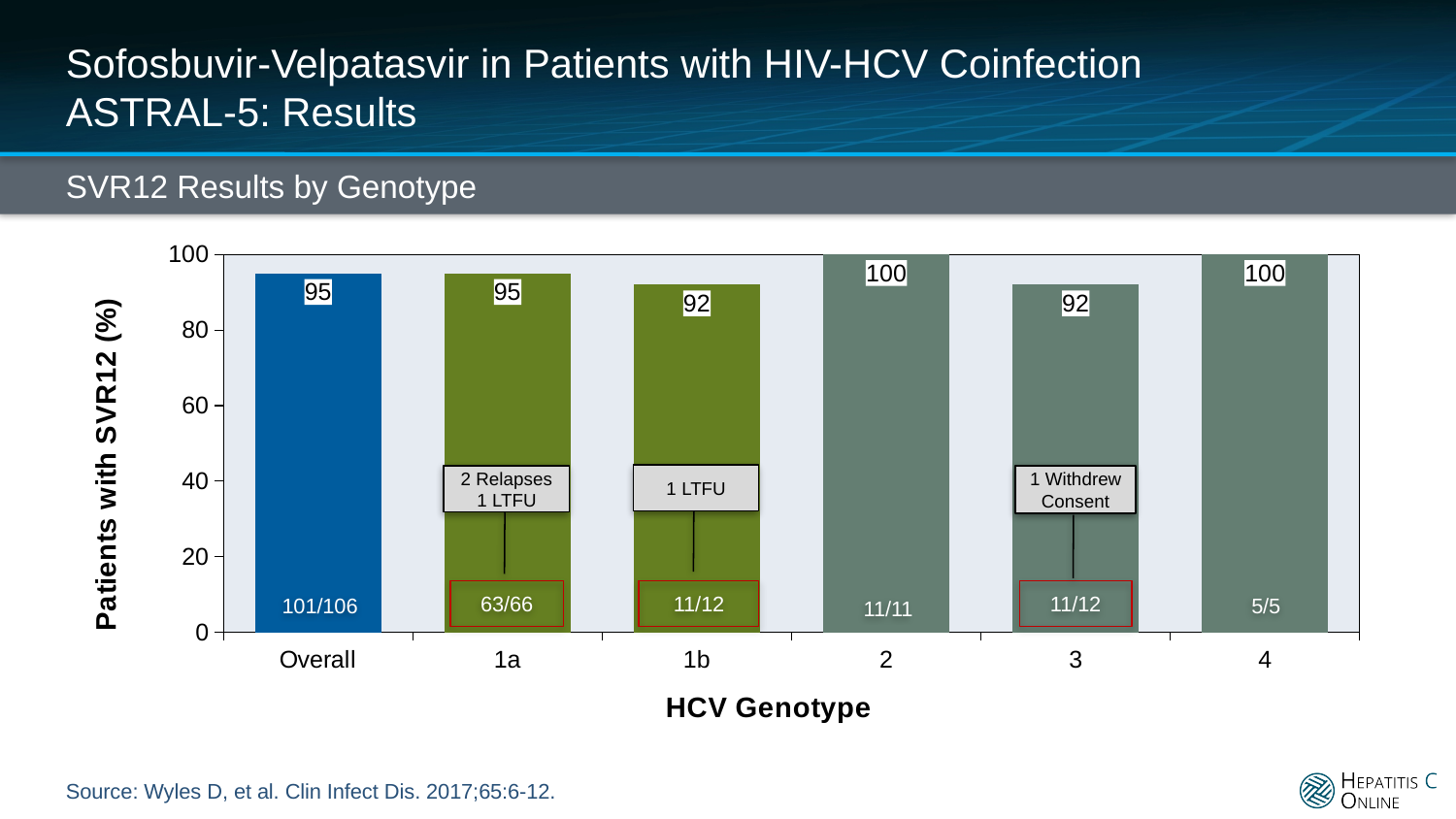
What is the SVR12 rate (%) for HCV genotype 3? 92 What is the difference in SVR12 rate between genotype 2 and genotype 1b? 8 What is the lowest SVR12 rate (%) shown on the chart? 92 What kind of chart is shown on the slide? Bar chart What reason is given in the annotation for the non-SVR12 patient in genotype 3? 1 Withdrew Consent Which HCV genotypes have the highest SVR12 rate? 2 and 4 Which has a higher SVR12 rate, genotype 1a or genotype 3? Genotype 1a What is the SVR12 rate (%) for the Overall group? 95 What is the SVR12 rate (%) for HCV genotype 1b? 92 What fraction of patients achieved SVR12 in the Overall group, as printed on the bar? 101/106 What fraction of patients achieved SVR12 for genotype 1a, as printed on the bar? 63/66 How many categories are shown on the x axis? 6